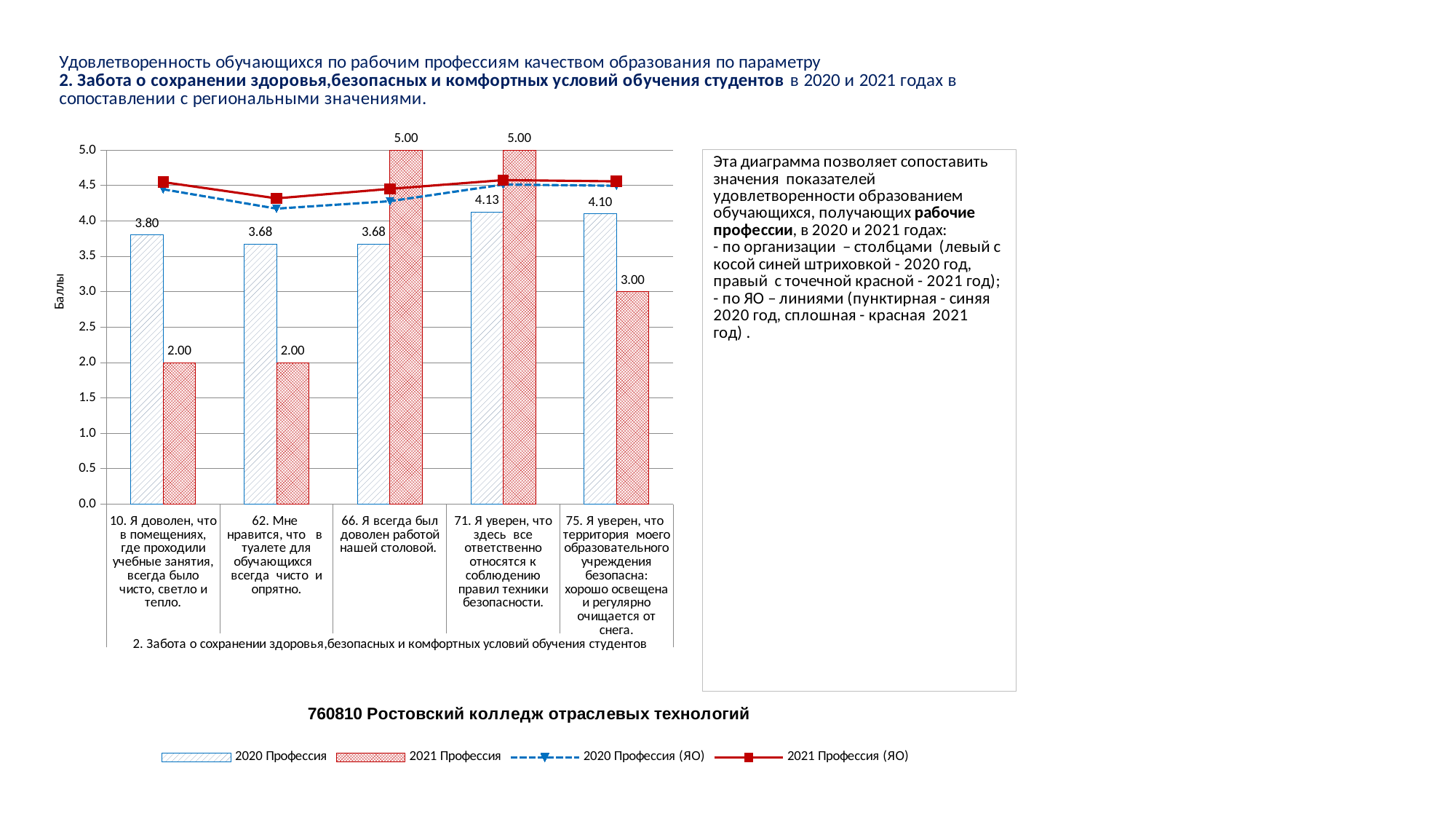
What is the value of the 2021 Профессия bar for category 66 (Я всегда был доволен работой нашей столовой)? 5.00 What is the difference between the 2021 Профессия and 2020 Профессия bar values for category 66? 1.32 How many series does the chart legend list? 4 Is the 2021 Профессия (ЯО) line value for category 62 greater or less than 4.0? greater What is the value of the 2021 Профессия bar for category 75 (Я уверен, что территория моего образовательного учреждения безопасна)? 3.00 How many categories are shown on the x axis of the chart? 5 What is the value of the 2021 Профессия bar for category 62 (Мне нравится, что в туалете для обучающихся всегда чисто и опрятно)? 2.00 For category 75, which is larger: the 2020 Профессия bar or the 2021 Профессия bar? 2020 Профессия Which category has the lowest 2021 Профессия bar value? 10 and 62 (both 2.00) What is the value of the 2020 Профессия bar for category 10 (Я доволен, что в помещениях, где проходили учебные занятия, всегда было чисто, светло и тепло)? 3.80 Which category has the highest 2020 Профессия bar value? 71. Я уверен, что здесь все ответственно относятся к соблюдению правил техники безопасности. What is the value of the 2020 Профессия bar for category 71 (Я уверен, что здесь все ответственно относятся к соблюдению правил техники безопасности)? 4.13